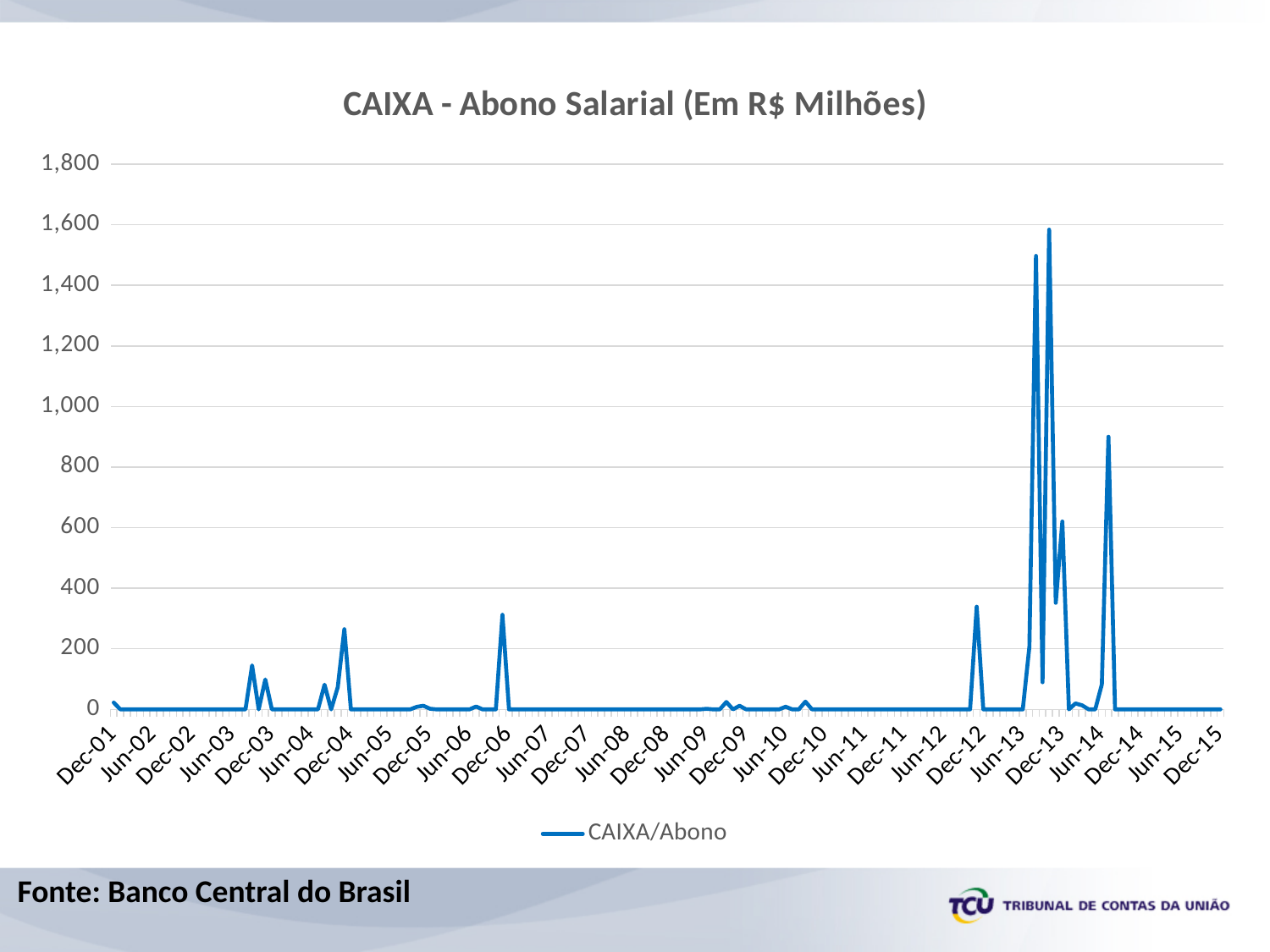
Which is larger: the peak near Dec-14 or the peak near Dec-12? The peak near Dec-14 How many date labels are shown on the x axis? 29 What kind of chart is shown on the slide? Line chart What is the title of the chart? CAIXA - Abono Salarial (Em R$ Milhões) Is the highest peak of the series, near Dec-13, greater or less than 1,400? greater Is the peak of the series near Dec-06 greater or less than 400? less In which year does the CAIXA/Abono series reach its highest value? 2013 What is the name of the series shown in the legend? CAIXA/Abono Is the peak of the series near Dec-14 greater or less than 800? greater Which is larger: the peak near Dec-06 or the peak near Dec-03? The peak near Dec-06 How many series does the legend list? 1